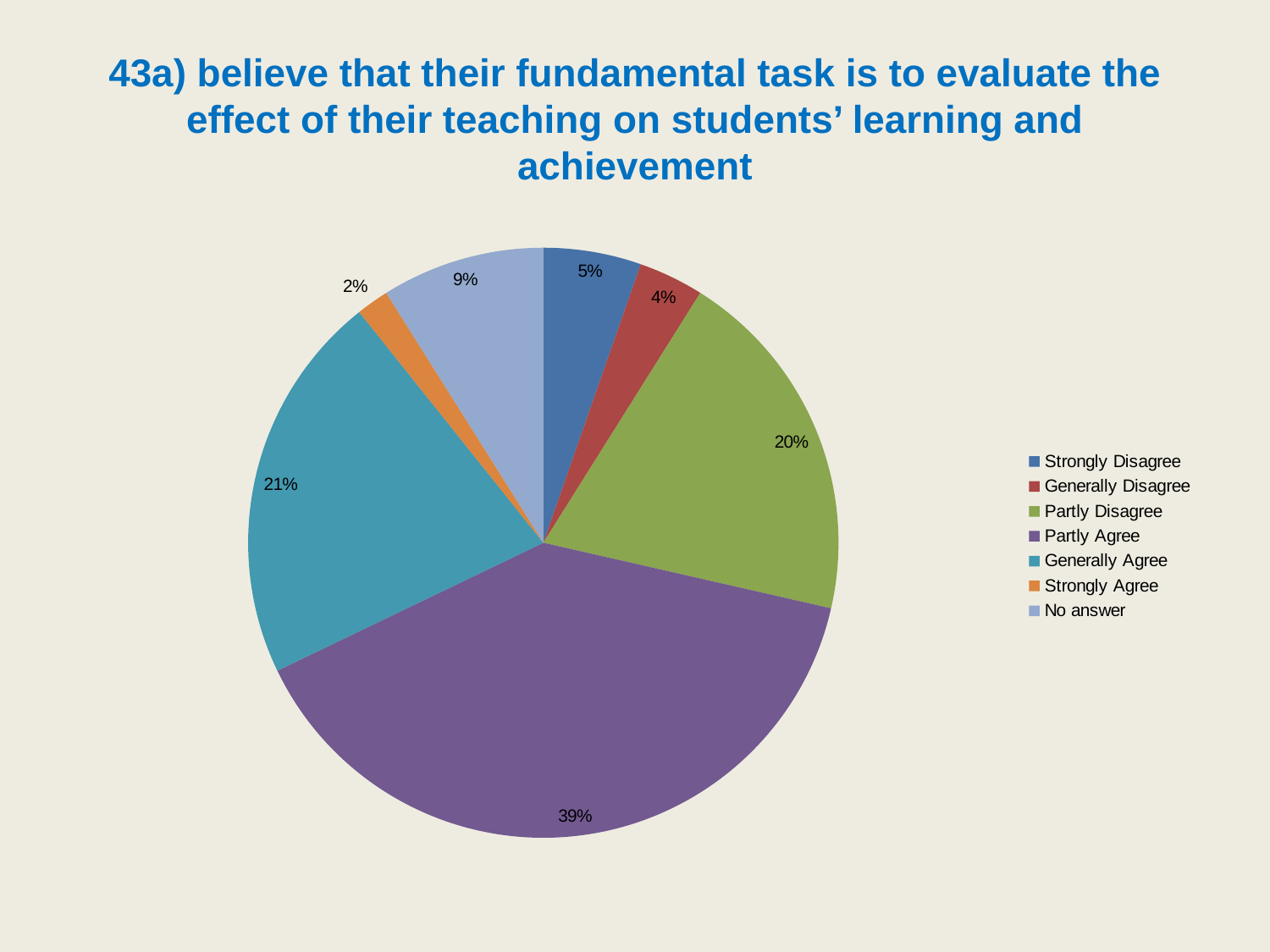
What is the difference between the Partly Agree and Generally Agree values? 18% What type of chart is shown on the slide? pie chart What is the value for Partly Disagree? 20% What is the value for Generally Agree? 21% What share of the pie does Partly Agree represent? 39% What colour is the Partly Disagree slice? green What is the value for No answer? 9% Which category has the smallest slice of the pie? Strongly Agree Which category has the largest slice of the pie? Partly Agree Which is larger, Strongly Disagree or Generally Disagree? Strongly Disagree How many categories does the legend list? 7 What is the value for Strongly Agree? 2%